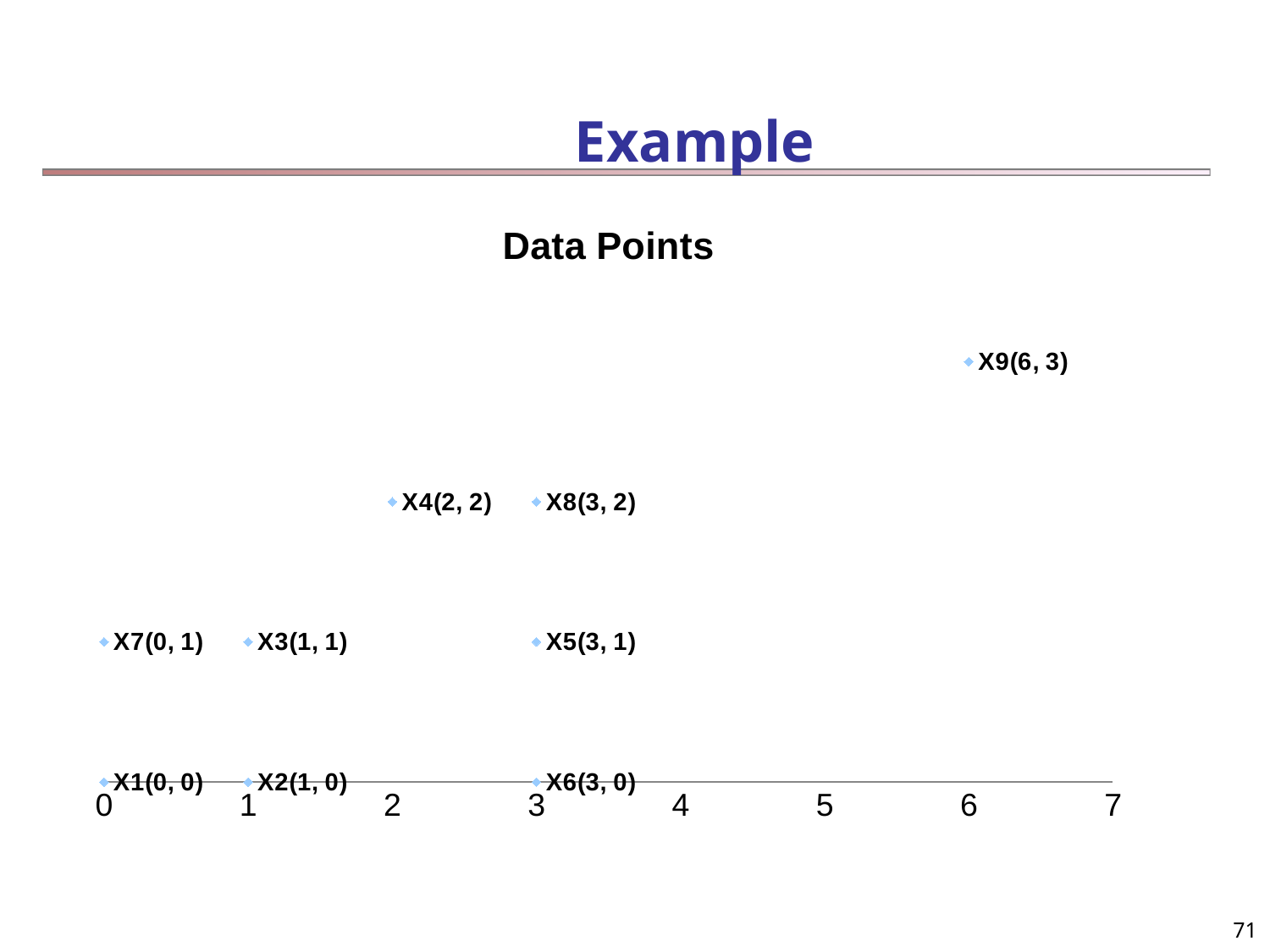
What is the maximum value shown on the x axis? 7 What are the coordinates of point X4? (2, 2) How many points lie on the x axis (y = 0)? 3 What kind of chart is shown on the slide? scatter chart Which point has the highest y value? X9 What are the coordinates of point X9? (6, 3) Which point has a larger y value, X4 or X5? X4 Which point has the largest x value? X9 How many data points are plotted in the chart? 9 What is the difference in x value between X9 and X8? 3 What are the coordinates of point X7? (0, 1) What is the title of the chart? Data Points